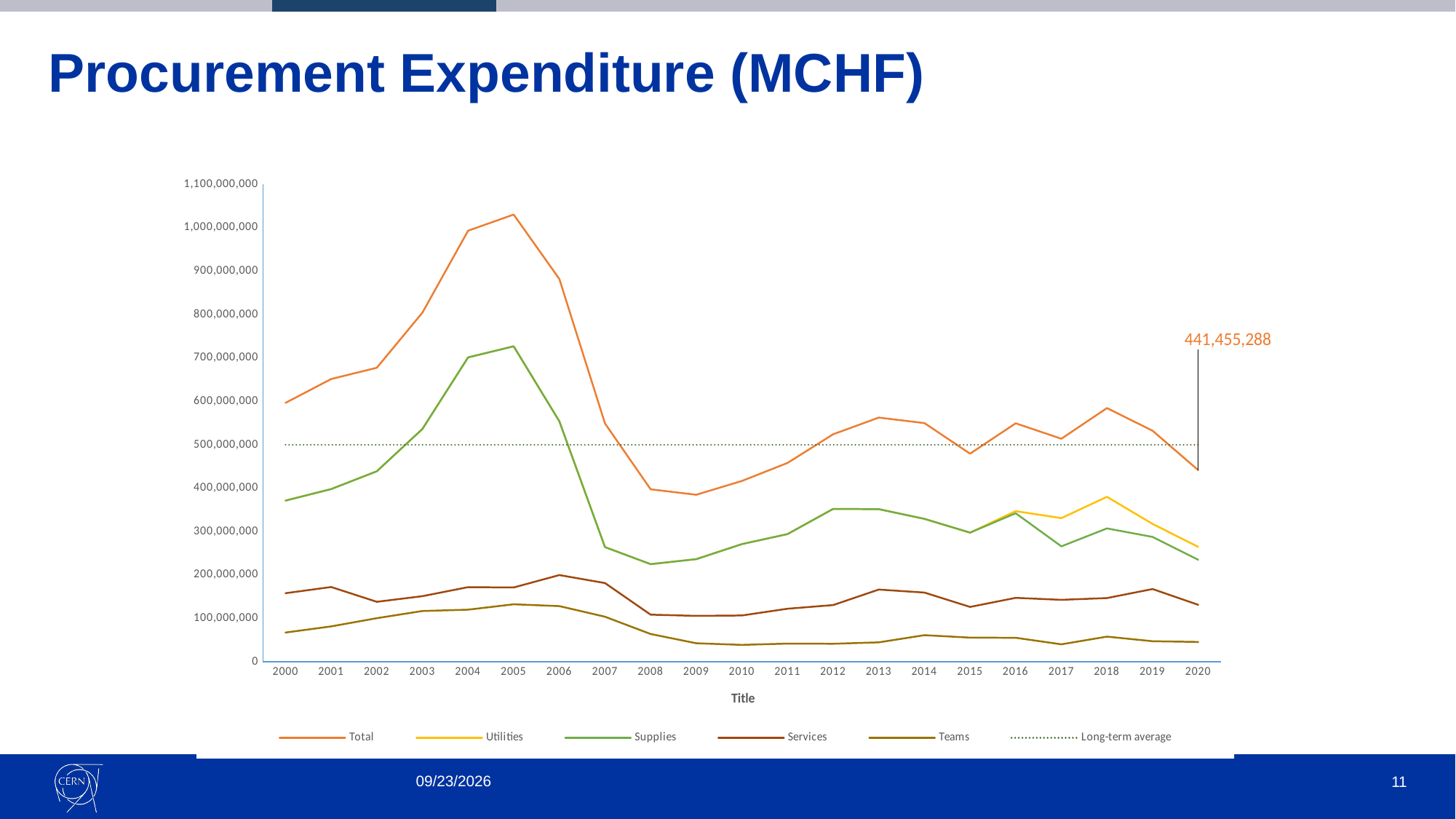
In which year is the Total series at its highest? 2005 How many years are shown on the x axis? 21 Does the Total series rise or fall from 2005 to 2009? fall Which legend entry is drawn as a dotted line? Long-term average Is the value of Total in 2000 greater or less than 500,000,000? greater Which is larger in 2010, Supplies or Services? Supplies Is the value of Teams in 2005 greater or less than 100,000,000? greater What is the value of the Total series in 2020? 441,455,288 In which year is the Supplies series at its highest? 2005 How many series does the legend list? 6 What kind of chart is shown on the slide? line chart Is the value of Supplies in 2008 greater or less than 300,000,000? less